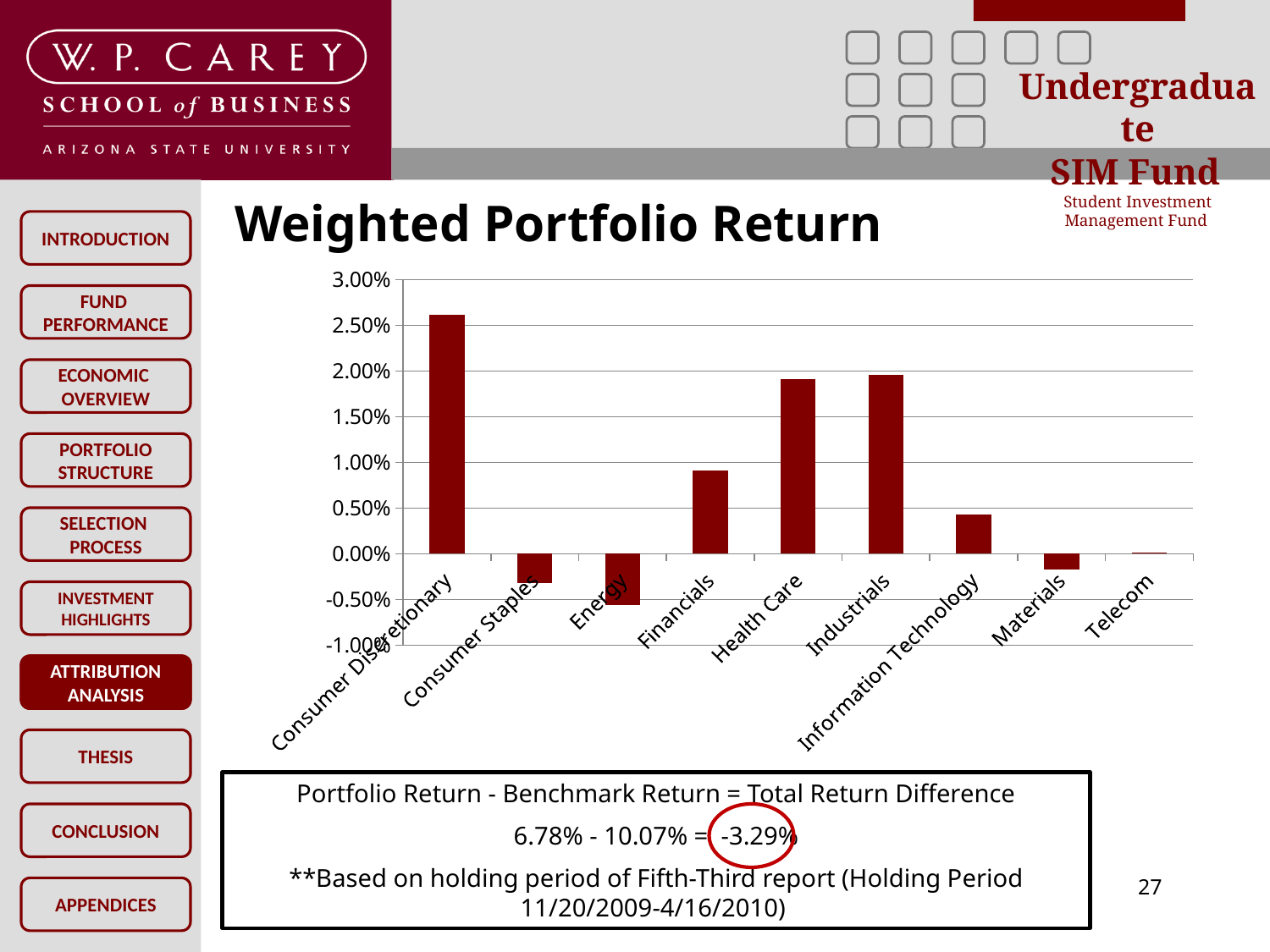
Is the value for Health Care greater or less than 1.50%? greater Which sector has the highest weighted portfolio return? Consumer Discretionary Is the value for Consumer Discretionary greater or less than 2.00%? greater Which is larger, the value for Consumer Discretionary or the value for Health Care? Consumer Discretionary Which is larger, the value for Financials or the value for Information Technology? Financials Which sector has the lowest weighted portfolio return? Energy Is the value for Energy greater or less than 0.00%? less What type of chart is shown on the slide? bar chart How many sectors are shown on the x axis of the chart? 9 What is the title of the chart? Weighted Portfolio Return